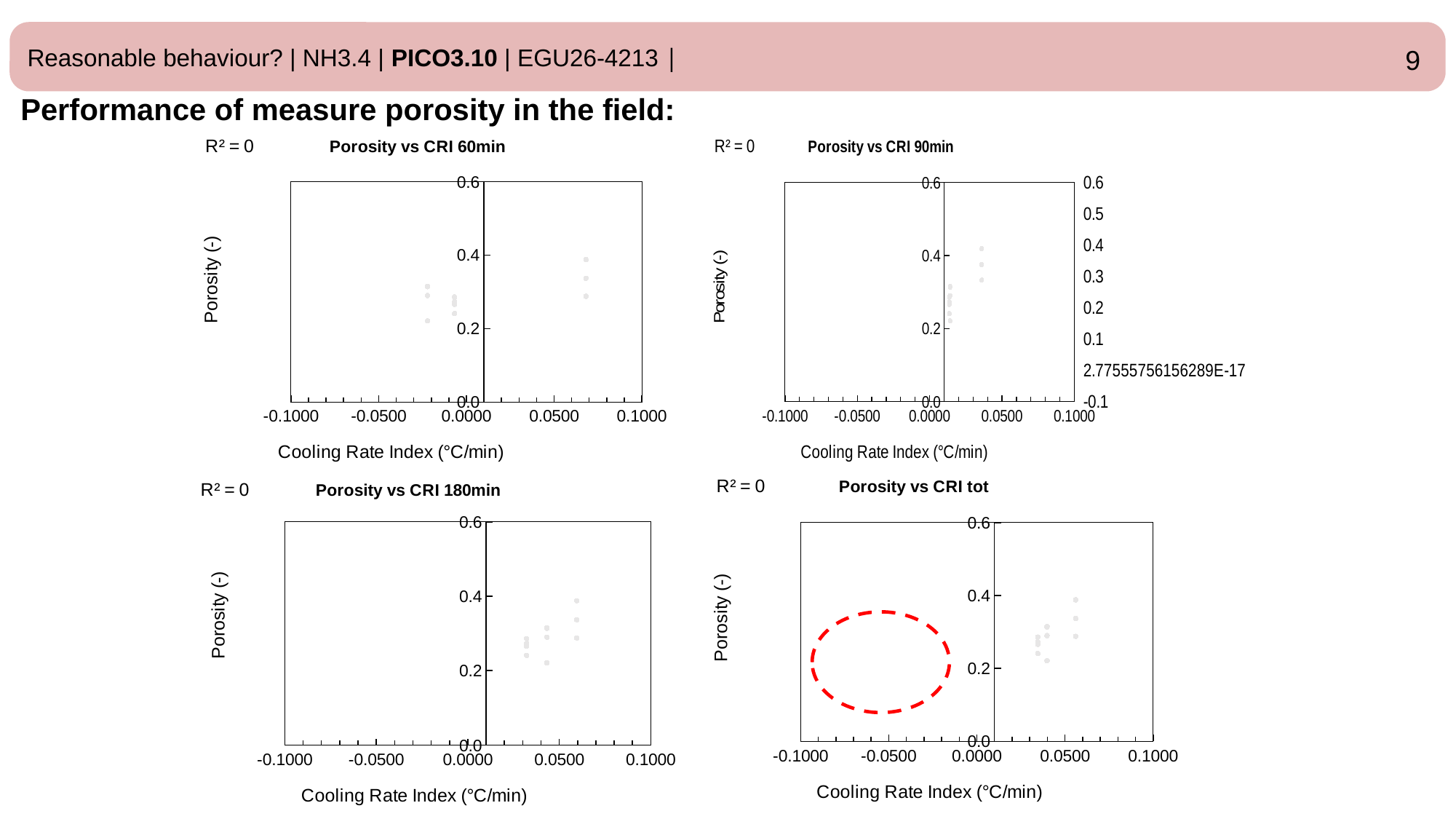
What is the x-axis label of the Porosity vs CRI 180min chart? Cooling Rate Index (°C/min) How many charts are shown on the slide? 4 In the Porosity vs CRI 90min chart, are all plotted porosity values greater or less than 0.6? less What kind of chart is the Porosity vs CRI 60min chart? scatter chart In the Porosity vs CRI tot chart, are all plotted points at a Cooling Rate Index greater or less than 0.0000? greater In the Porosity vs CRI 180min chart, are all plotted porosity values greater or less than 0.1? greater What R² value is printed next to the Porosity vs CRI 90min chart? R² = 0 What is the maximum value shown on the y-axis of the Porosity vs CRI 60min chart? 0.6 What is the title of the bottom-right chart? Porosity vs CRI tot